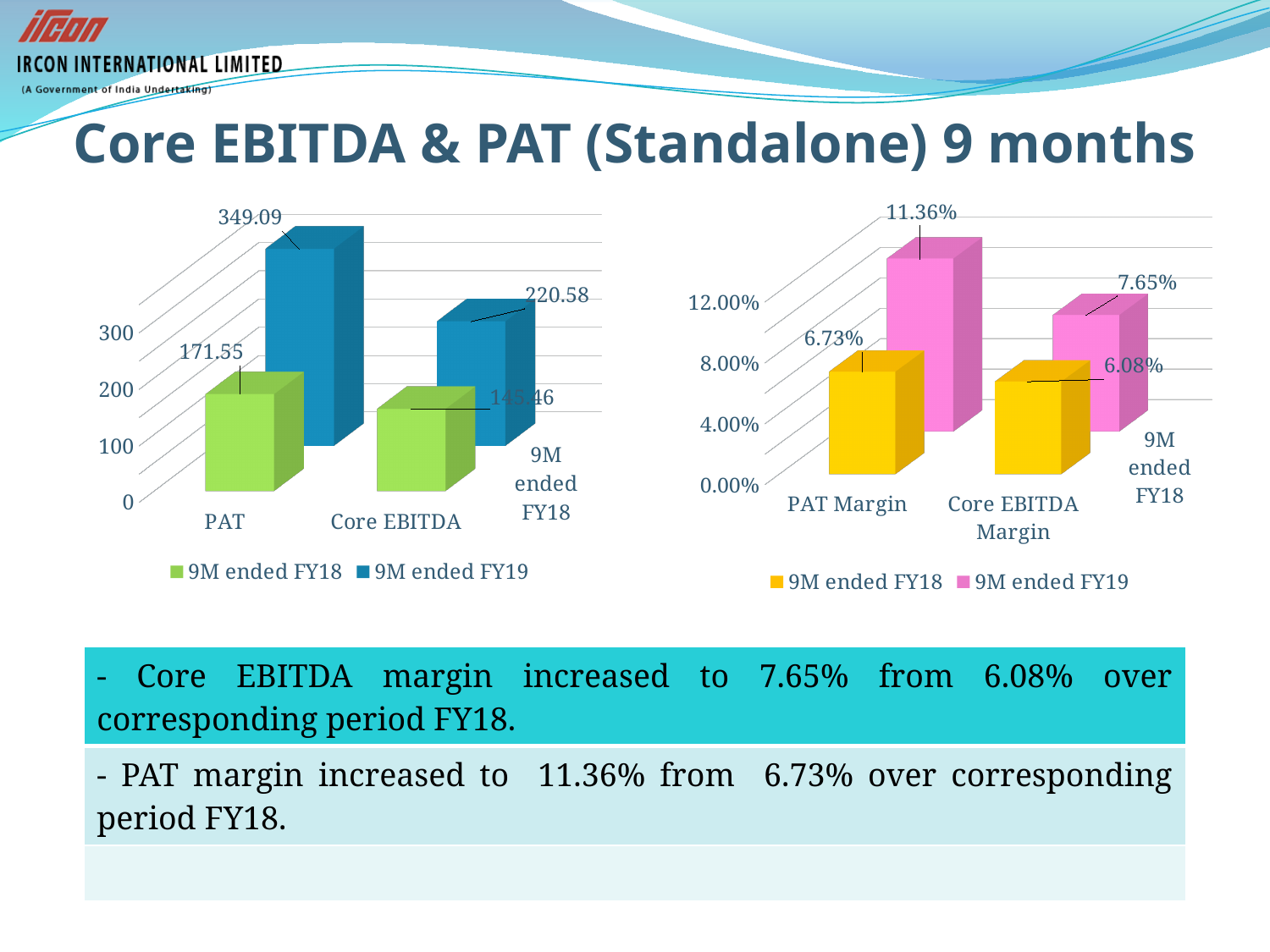
In the left chart, what is the difference between PAT for 9M ended FY19 and 9M ended FY18? 177.54 In the left chart, how many series does the legend list? 2 In the right chart, what is the Core EBITDA Margin for 9M ended FY18? 6.08% In the right chart, which is larger: the PAT Margin for 9M ended FY18 or the Core EBITDA Margin for 9M ended FY18? PAT Margin for 9M ended FY18 In the right chart, what is the difference between the Core EBITDA Margin for 9M ended FY19 and 9M ended FY18? 1.57% What kind of chart is the left chart? Bar chart In the left chart, what is the PAT value for 9M ended FY18? 171.55 In the left chart, what is the Core EBITDA value for 9M ended FY19? 220.58 In the left chart, is the Core EBITDA value for 9M ended FY18 greater or less than 200? less In the left chart, which bar is the tallest? PAT, 9M ended FY19 In the right chart, what is the PAT Margin for 9M ended FY19? 11.36% In the left chart, what is the PAT value for 9M ended FY19? 349.09